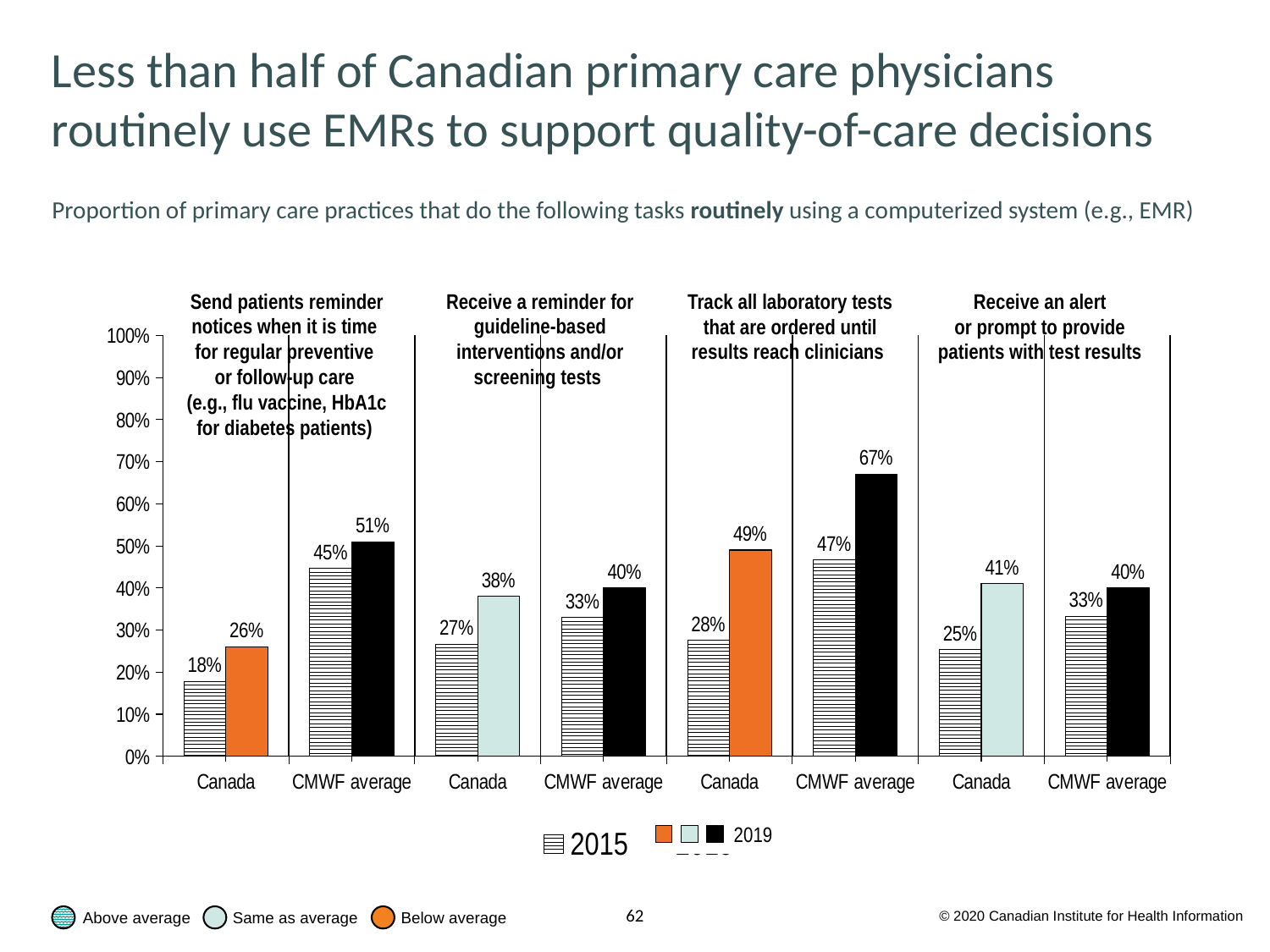
What is the 2015 value for the CMWF average for tracking all laboratory tests that are ordered until results reach clinicians? 47% Which bar has the lowest value on the chart? Canada 2015 for sending patients reminder notices (18%) How many series does the legend list? 2 What kind of chart is shown on the slide? Bar chart What is the 2019 value for Canada for sending patients reminder notices when it is time for regular preventive or follow-up care? 26% Which year is shown with the striped bars in the legend? 2015 What is the 2015 value for Canada for receiving a reminder for guideline-based interventions and/or screening tests? 27% What is the difference between the 2019 CMWF average and the 2019 Canada value for tracking all laboratory tests? 18% For receiving an alert or prompt to provide patients with test results, which is larger in 2019: Canada or the CMWF average? Canada What is the 2019 value for Canada for receiving an alert or prompt to provide patients with test results? 41% By how much did Canada's value for sending patients reminder notices increase from 2015 to 2019? 8% Which bar has the highest value on the chart? CMWF average 2019 for tracking all laboratory tests (67%)